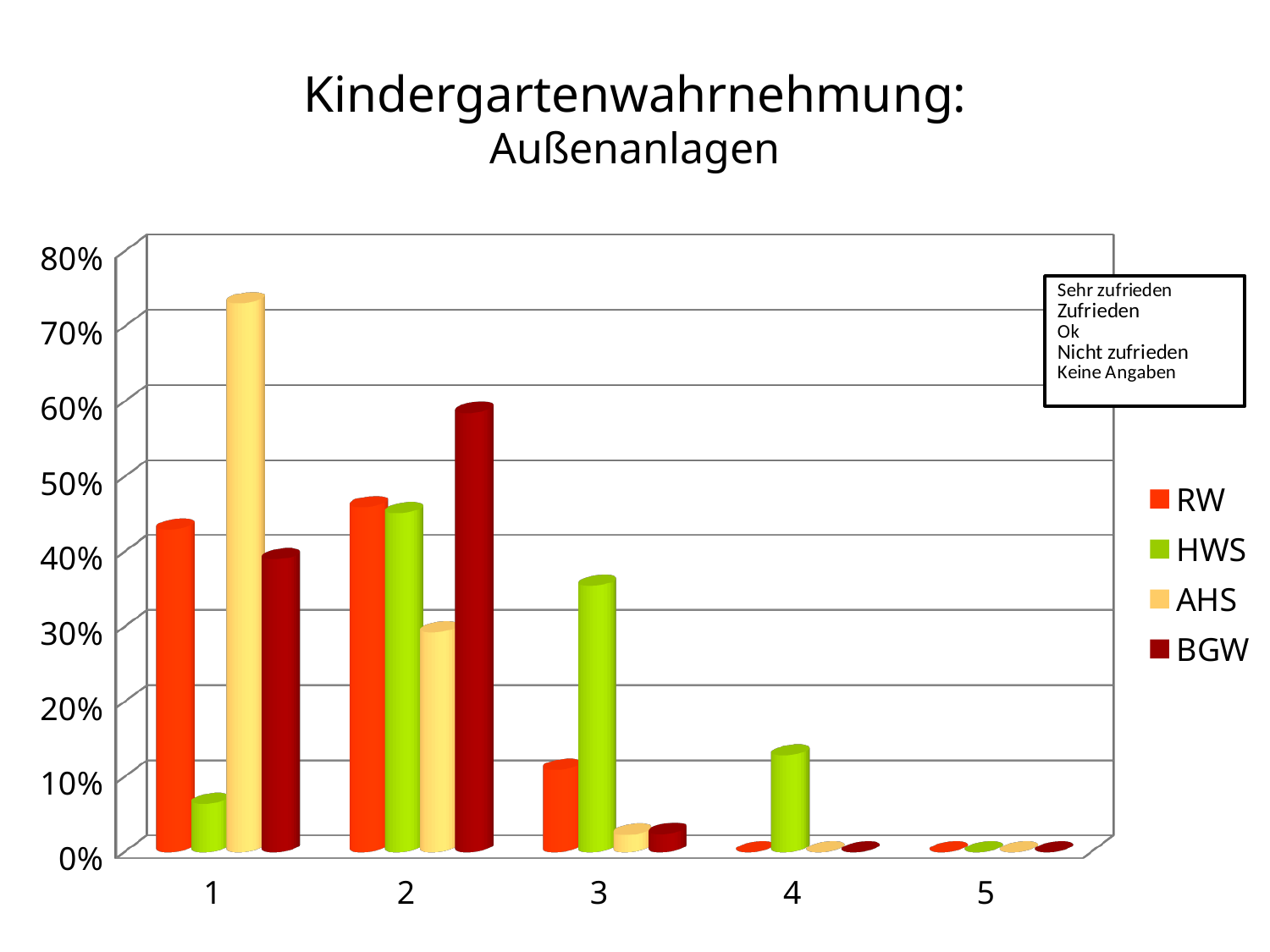
Which series has the highest bar in category 1? AHS What is the title of the chart? Kindergartenwahrnehmung: Außenanlagen Is the value for BGW in category 2 greater or less than 50%? greater Which is larger in category 1: the value for RW or the value for BGW? RW Which series has the highest bar in category 2? BGW Which series has the lowest bar in category 1? HWS How many series does the legend list? 4 What kind of chart is shown on the slide? bar chart Which series has the highest bar in category 3? HWS Is the value for AHS in category 1 greater or less than 70%? greater Is the value for HWS in category 4 greater or less than 20%? less How many categories are shown on the x axis? 5